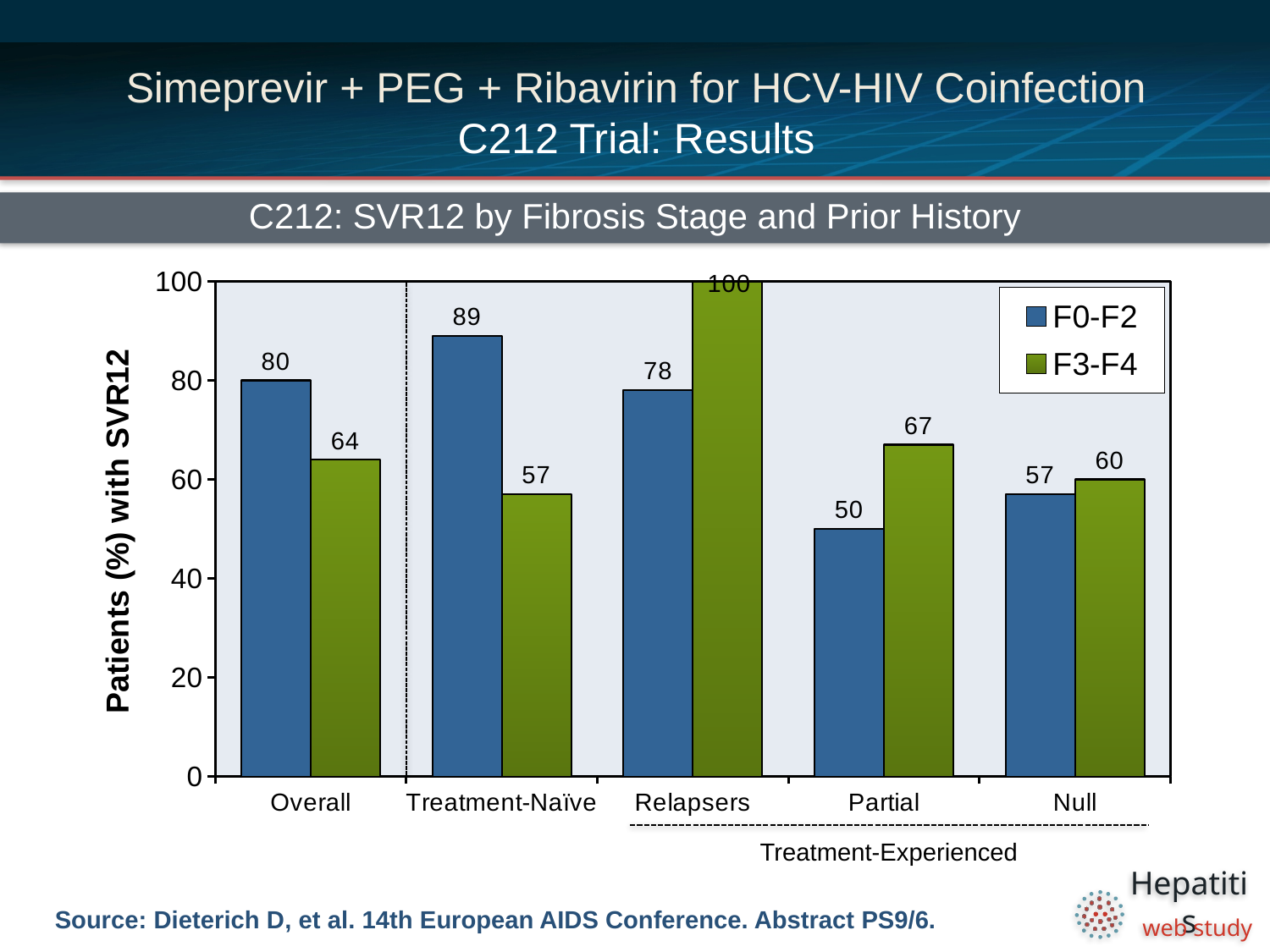
What is the SVR12 rate for F0-F2 patients in the Overall group? 80 What is the SVR12 rate for F3-F4 patients among Relapsers? 100 How many series does the legend list? 2 What kind of chart is shown on the slide? Bar chart What is the SVR12 rate for F0-F2 patients in the Partial group? 50 What is the difference between the F0-F2 and F3-F4 SVR12 rates in the Treatment-Naïve group? 32 Which category has the highest SVR12 rate for the F0-F2 series? Treatment-Naïve In the Null group, which series has the higher SVR12 rate, F0-F2 or F3-F4? F3-F4 How many categories are shown on the x axis? 5 What is the SVR12 rate for F3-F4 patients in the Treatment-Naïve group? 57 Which category has the lowest SVR12 rate for the F3-F4 series? Treatment-Naïve What is the label of the y axis? Patients (%) with SVR12